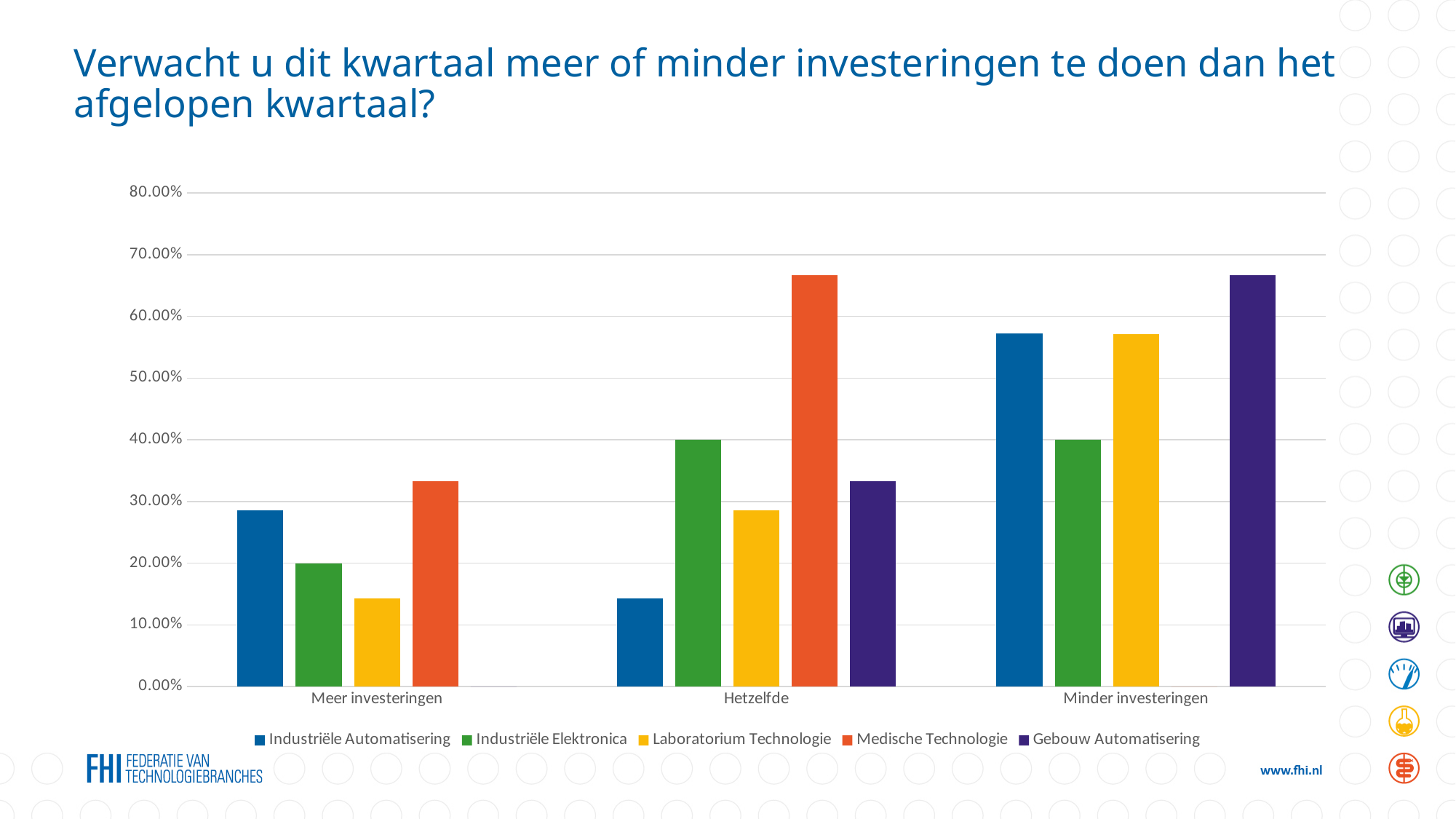
Which is larger: Laboratorium Technologie in 'Meer investeringen' or Laboratorium Technologie in 'Hetzelfde'? Hetzelfde Which series has the highest value in the 'Meer investeringen' category? Medische Technologie Which is larger: Industriële Automatisering in 'Meer investeringen' or Industriële Automatisering in 'Minder investeringen'? Minder investeringen What kind of chart is shown on the slide? bar chart Which series has the highest value in the 'Hetzelfde' category? Medische Technologie Which series is shown in orange in the legend? Medische Technologie Which series has the lowest value in the 'Hetzelfde' category? Industriële Automatisering How many series does the legend list? 5 Is the value for Medische Technologie in 'Hetzelfde' greater or less than 60.00%? greater Is the value for Industriële Automatisering in 'Hetzelfde' greater or less than 20.00%? less How many categories are shown on the x axis? 3 Which series has the highest value in the 'Minder investeringen' category? Gebouw Automatisering